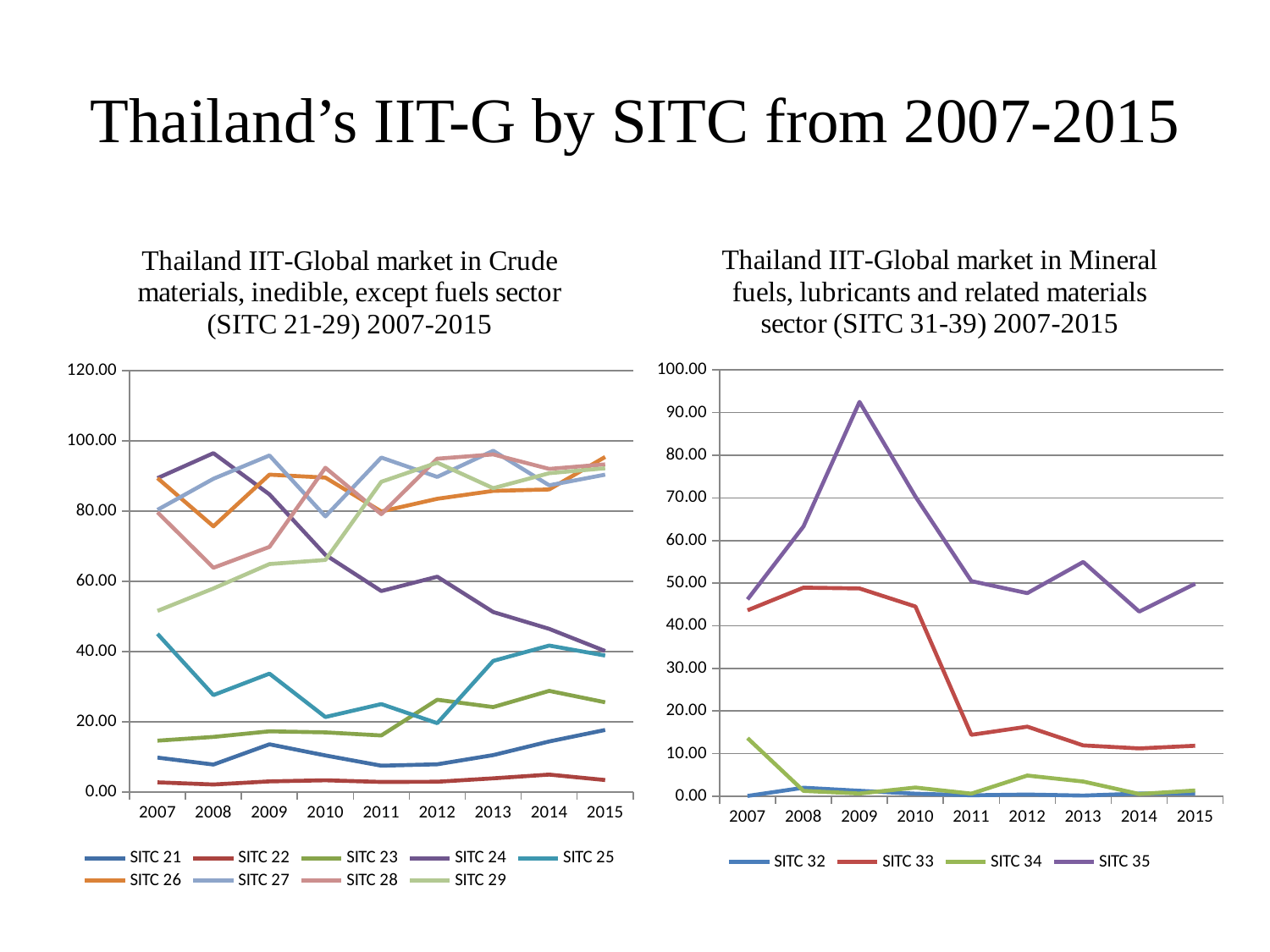
In the right chart (SITC 31-39), is the value for SITC 33 in 2011 greater or less than 20.00? less In the right chart (SITC 31-39), which is larger in 2010, SITC 35 or SITC 33? SITC 35 In the left chart (SITC 21-29), which series has the lowest value in 2015? SITC 22 In the right chart (SITC 31-39), is the value for SITC 35 in 2009 greater or less than 80.00? greater How many years are plotted along the x axis of the right chart (SITC 31-39)? 9 How many series does the legend of the left chart (SITC 21-29) list? 9 How many series does the legend of the right chart (SITC 31-39) list? 4 In the right chart (SITC 31-39), does SITC 33 rise or fall from 2007 to 2015? fall What type of chart is the left chart (SITC 21-29)? line chart In the left chart (SITC 21-29), is the value for SITC 25 in 2007 greater or less than 40.00? greater In the left chart (SITC 21-29), does SITC 24 rise or fall from 2007 to 2015? fall In the right chart (SITC 31-39), in which year does SITC 35 reach its highest value? 2009